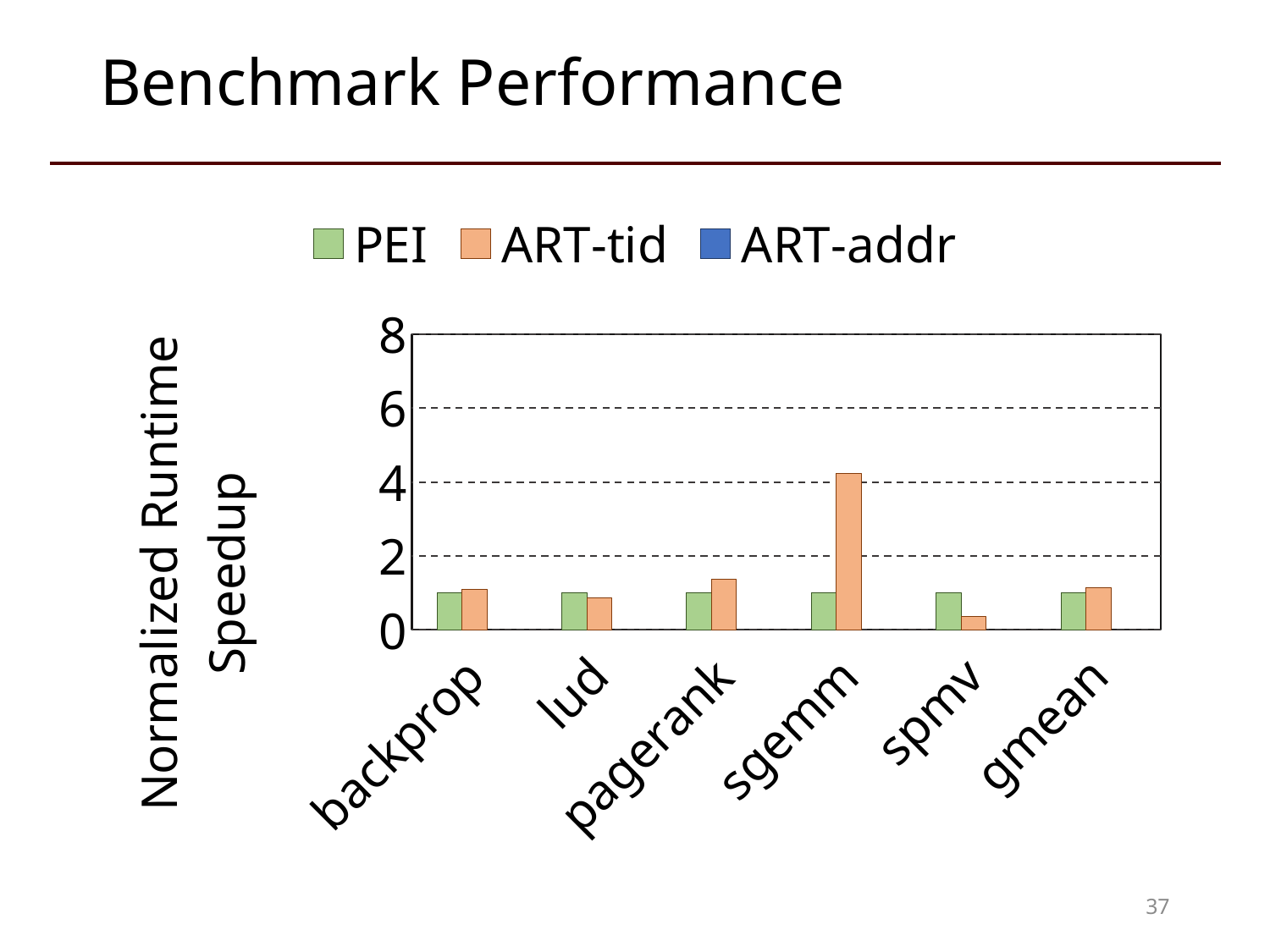
How many series does the legend list? 3 Is the ART-tid value for spmv greater or less than 2? less For pagerank, which series has the larger value, PEI or ART-tid? ART-tid For spmv, which series has the larger value, PEI or ART-tid? PEI What is the label on the y axis of the chart? Normalized Runtime Speedup How many benchmark categories are shown on the x axis? 6 For sgemm, which series has the larger value, PEI or ART-tid? ART-tid Which benchmark has the highest ART-tid speedup? sgemm Is the ART-tid value for sgemm greater or less than 6? less Which benchmark has the lowest ART-tid speedup? spmv What kind of chart is shown on the slide? bar chart Is the ART-tid value for sgemm greater or less than 2? greater